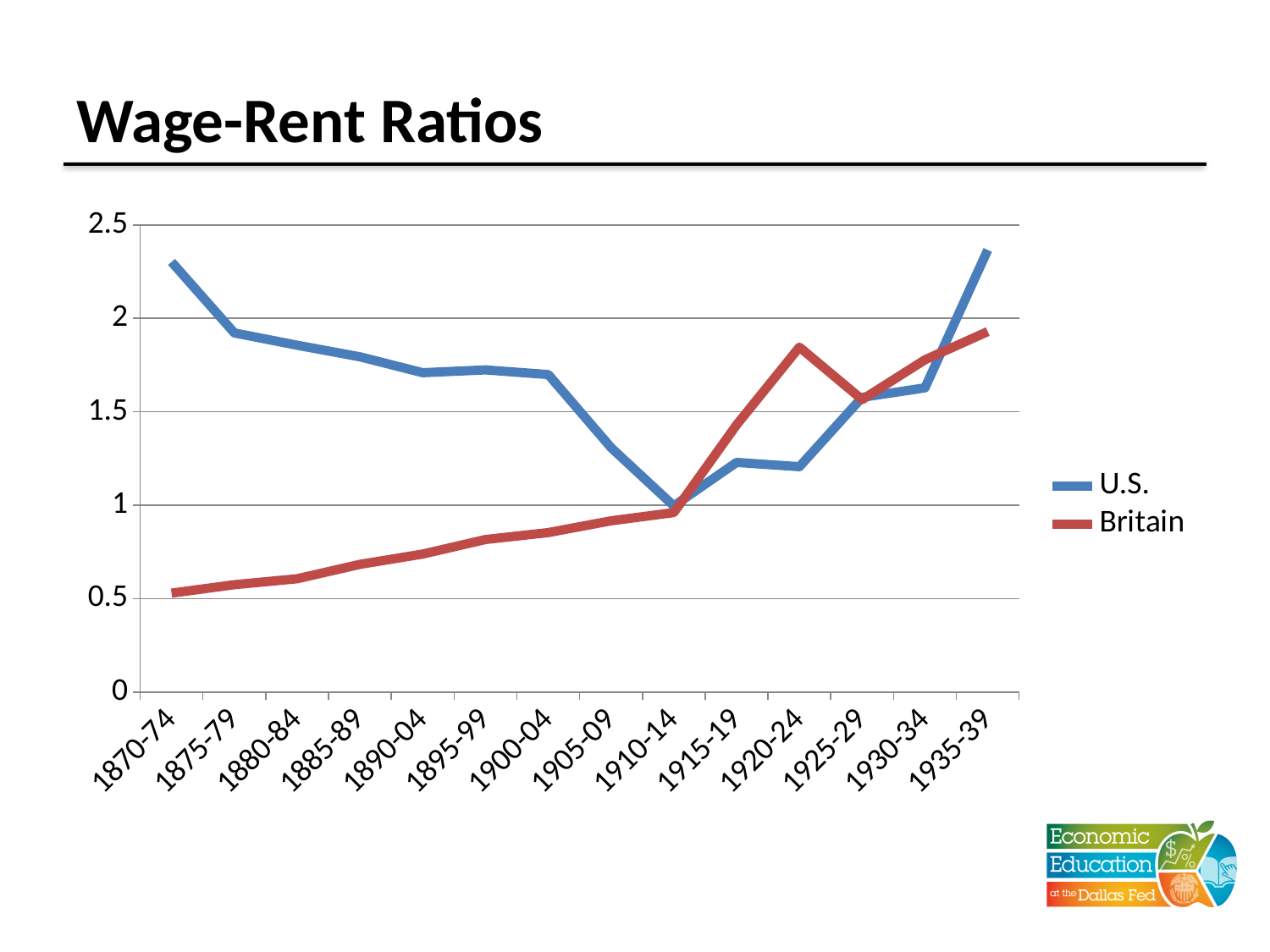
Does the Britain series rise or fall from 1870-74 to 1910-14? rise What is the title of the chart? Wage-Rent Ratios In 1920-24, which series has the larger value, U.S. or Britain? Britain In 1935-39, which series has the larger value, U.S. or Britain? U.S. Is the U.S. value for 1870-74 greater or less than 2? greater Is the Britain value for 1920-24 greater or less than 1.5? greater What kind of chart is shown on the slide? line chart Which series has the lowest value in 1870-74? Britain In which period does the U.S. series reach its lowest value? 1910-14 How many series does the legend list? 2 How many time periods are shown on the x axis? 14 In which period does the Britain series have its lowest value? 1870-74